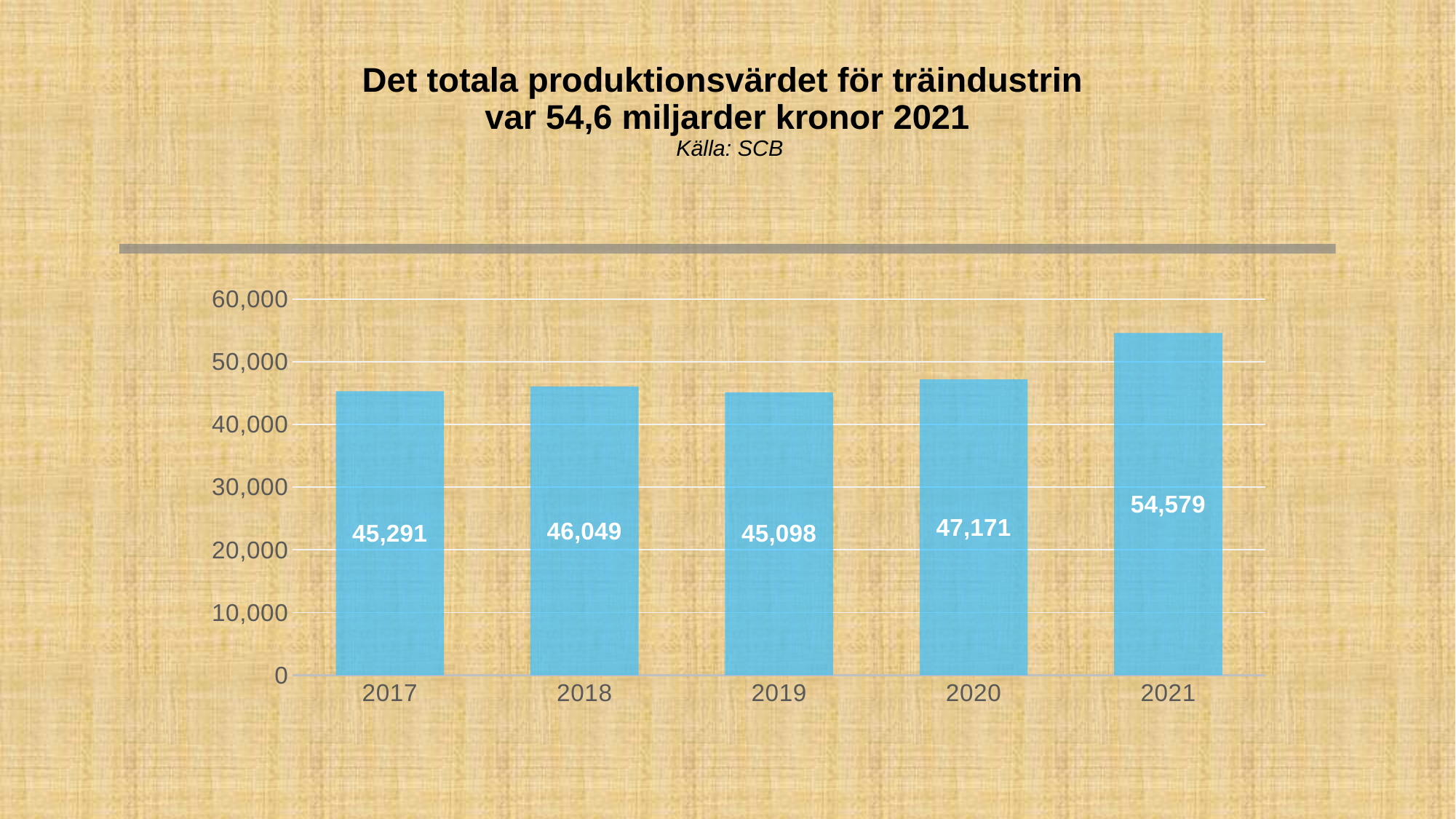
How many years are shown on the x axis? 5 What is the value for 2019? 45,098 What is the value for 2021? 54,579 What is the value for 2017? 45,291 Which year has the lowest value? 2019 What is the difference between the values for 2021 and 2020? 7,408 Is the value for 2021 greater or less than 50,000? greater Which year has the highest value? 2021 What kind of chart is shown on the slide? bar chart What is the difference between the values for 2018 and 2017? 758 What is the source cited below the slide title? SCB Which is larger, the value for 2020 or the value for 2018? 2020